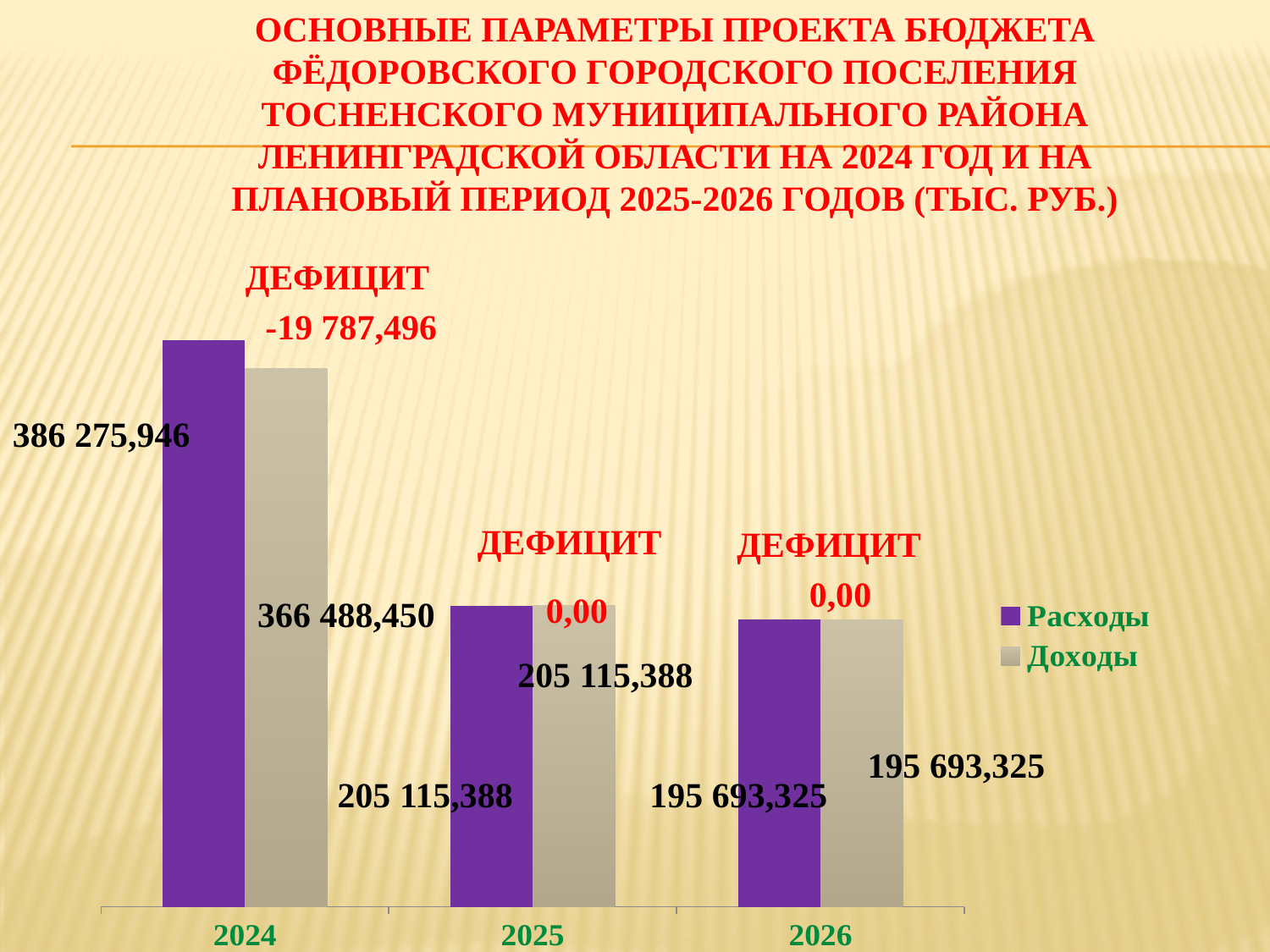
Do the Расходы values rise or fall from 2024 to 2026? fall Which is larger in 2024, Расходы or Доходы? Расходы What is the value of Доходы for 2026? 195 693,325 How many series does the legend list? 2 What is the value of Расходы for 2025? 205 115,388 What is the value of Расходы for 2024? 386 275,946 In which year is Доходы the lowest? 2026 What type of chart is shown on the slide? bar chart What is the difference between Расходы and Доходы in 2024? 19 787,496 In which year is Расходы the highest? 2024 How many years (categories) are shown on the x axis? 3 What is the value of Доходы for 2024? 366 488,450